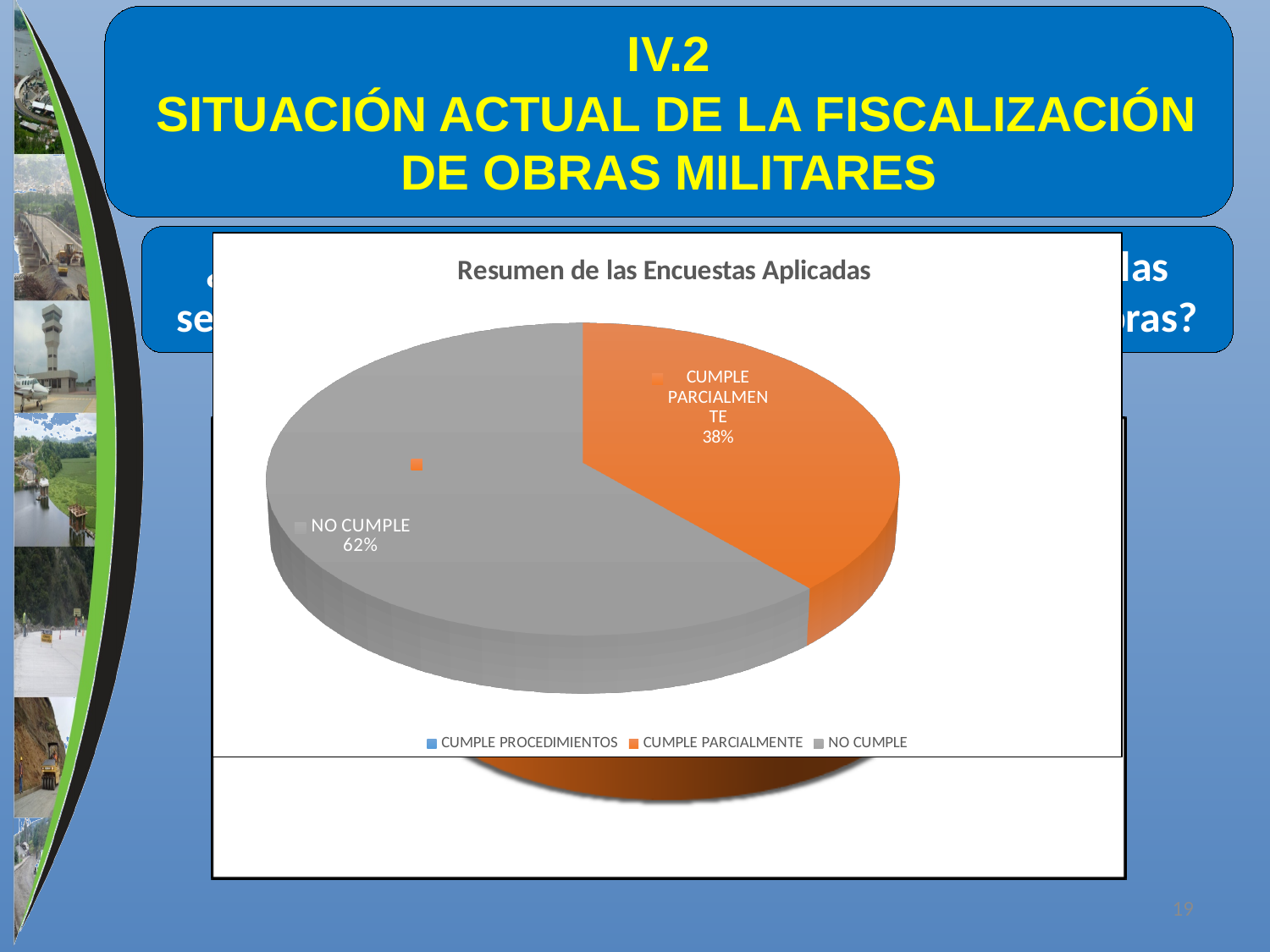
Is the share for NO CUMPLE greater or less than 50%? greater What kind of chart is shown on the slide? pie chart What share of the pie does NO CUMPLE represent? 62% How many entries does the legend list? 3 What share of the pie does CUMPLE PARCIALMENTE represent? 38% Which category has the largest slice of the pie? NO CUMPLE Is the share for CUMPLE PARCIALMENTE greater or less than 50%? less What is the title of the chart? Resumen de las Encuestas Aplicadas Which is larger, the NO CUMPLE slice or the CUMPLE PARCIALMENTE slice? NO CUMPLE Which legend entry is shown in orange? CUMPLE PARCIALMENTE What is the difference in percentage points between the NO CUMPLE and CUMPLE PARCIALMENTE slices? 24